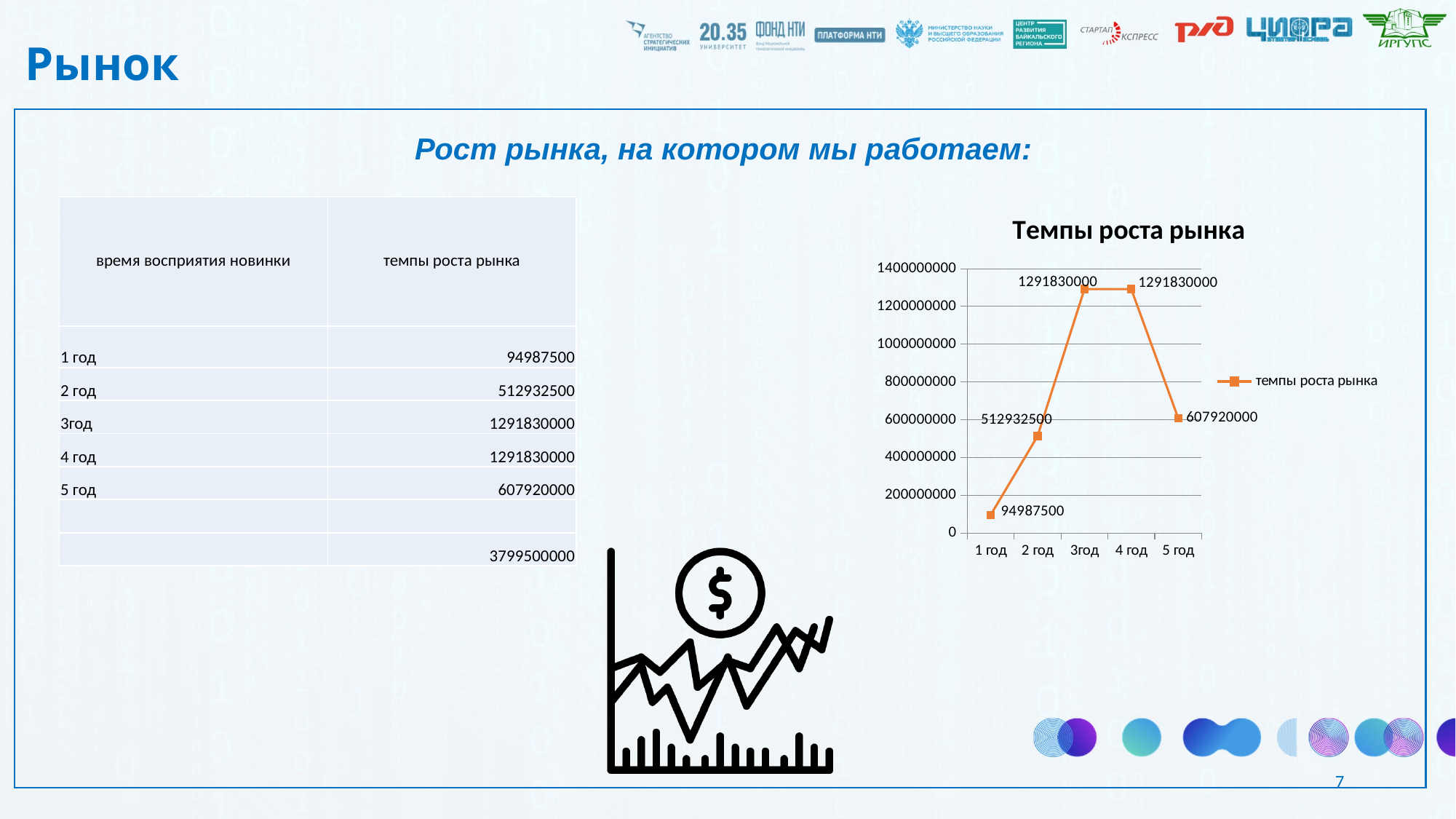
How many categories are shown on the x axis of the chart? 5 What is the value for 5 год in the chart? 607920000 What kind of chart is shown on the slide? line chart What is the difference between the values for 5 год and 2 год? 94987500 Which category has the lowest value in the chart? 1 год What is the value for 4 год in the chart? 1291830000 Which is larger, the value for 2 год or the value for 5 год? 5 год Is the value for 3год greater or less than 1000000000? greater What is the value for 1 год in the chart? 94987500 What is the difference between the values for 3год and 5 год? 683910000 What is the value for 2 год in the chart? 512932500 Do the values rise or fall from 1 год to 3год? rise